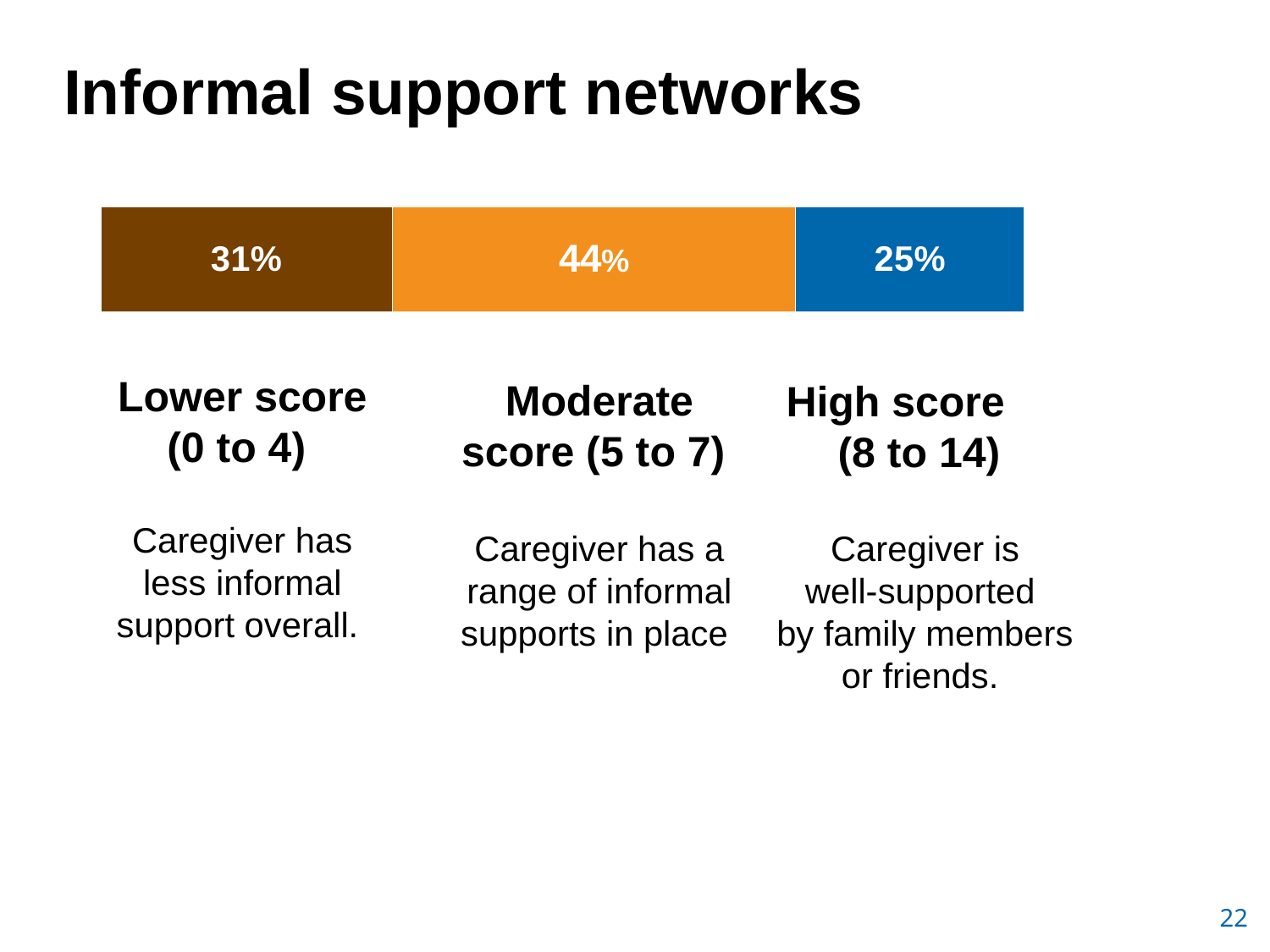
What percentage of caregivers have a high score (8 to 14)? 25% Which is larger, the share with a lower score (0 to 4) or the share with a high score (8 to 14)? Lower score (0 to 4) What percentage of caregivers have a lower score (0 to 4) on informal support networks? 31% What is the difference in percentage points between the moderate score and the high score segments? 19 What is the difference in percentage points between the lower score and the high score segments? 6 What percentage of caregivers have a moderate score (5 to 7)? 44% How many score categories are shown in the bar? 3 Which score category has the largest share of caregivers? Moderate score (5 to 7) What is the title of the slide containing the chart? Informal support networks What is the total of the three segments in the stacked bar? 100% What kind of chart is shown on the slide? Stacked bar chart Which score category has the smallest share of caregivers? High score (8 to 14)